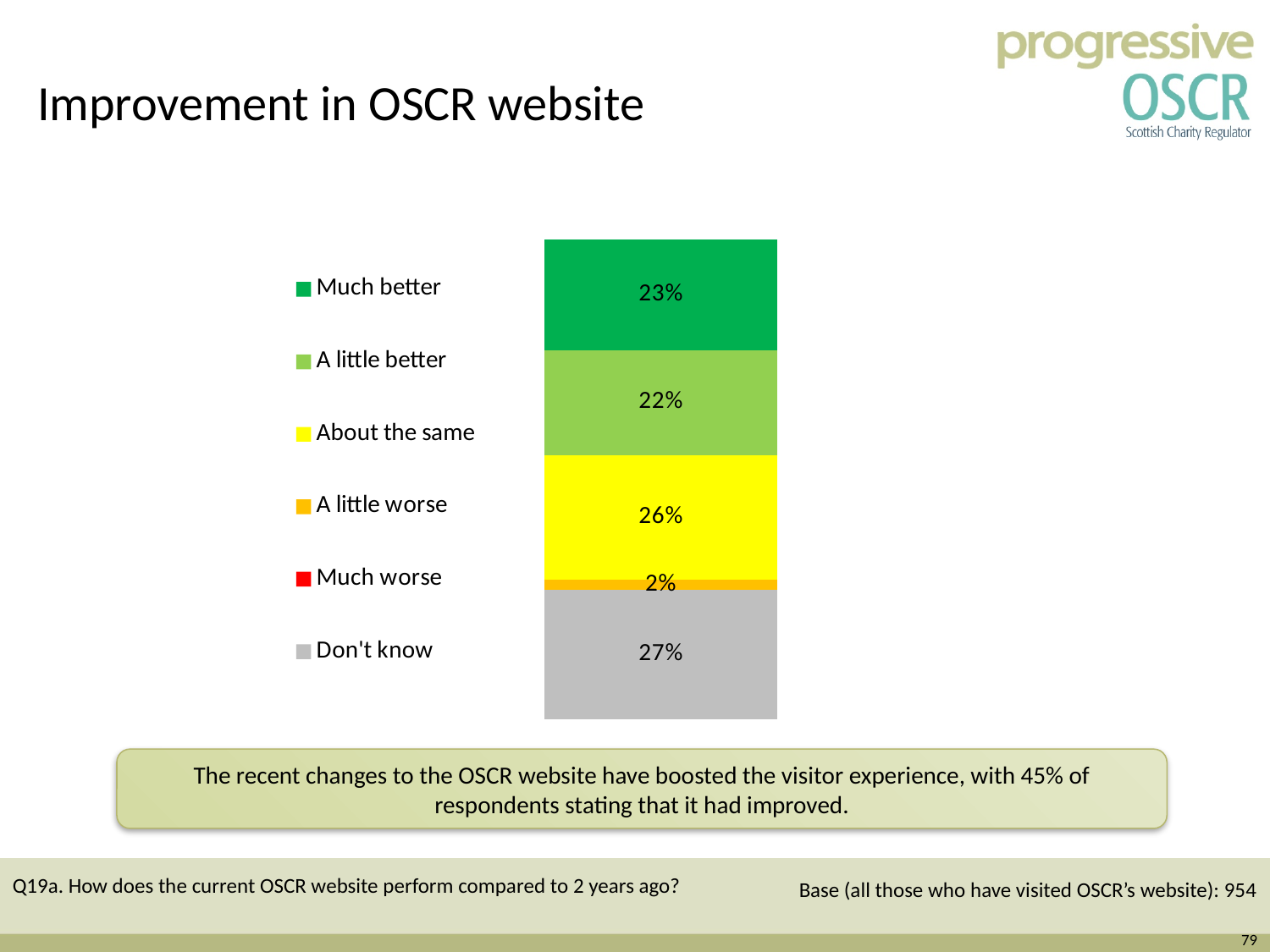
What is the difference between the "Much better" and "A little better" percentages? 1 percentage point What percentage of respondents answered "Don't know"? 27% What colour represents "About the same" in the chart? Yellow What percentage of respondents said the OSCR website is "Much better"? 23% What percentage of respondents said the website is "About the same"? 26% How many response categories does the legend list? 6 What percentage of respondents said the website is "A little worse"? 2% What percentage of respondents said the website is "A little better"? 22% What type of chart is shown on the slide? Stacked bar chart Which is larger, the share for "About the same" or for "Much better"? About the same Which response category has the largest share in the stacked bar? Don't know Which labelled segment of the bar has the smallest value? A little worse